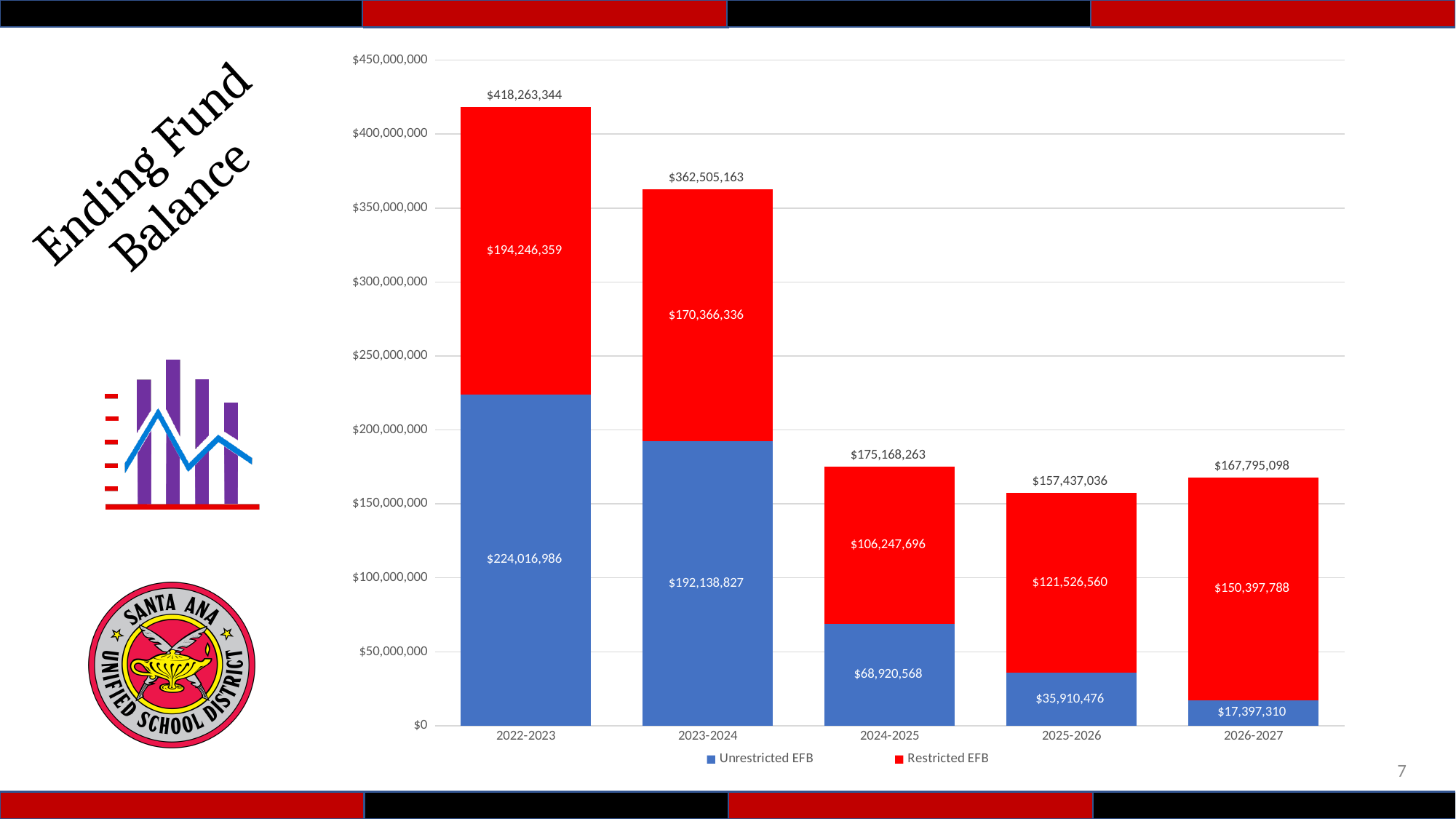
Does the Unrestricted EFB value rise or fall from 2022-2023 to 2026-2027? fall What is the Restricted EFB value for 2026-2027? $150,397,788 What is the Unrestricted EFB value for 2022-2023? $224,016,986 Is the total ending fund balance for 2024-2025 greater or less than $200,000,000? less How many series does the legend list? 2 How many fiscal years are shown on the x axis? 5 What is the difference between the Unrestricted EFB values for 2022-2023 and 2023-2024? $31,878,159 In 2025-2026, which is larger: Unrestricted EFB or Restricted EFB? Restricted EFB Which year has the lowest Unrestricted EFB value? 2026-2027 What is the difference between the total ending fund balances for 2022-2023 and 2023-2024? $55,758,181 Which year has the highest total ending fund balance? 2022-2023 What is the total ending fund balance shown for 2024-2025? $175,168,263